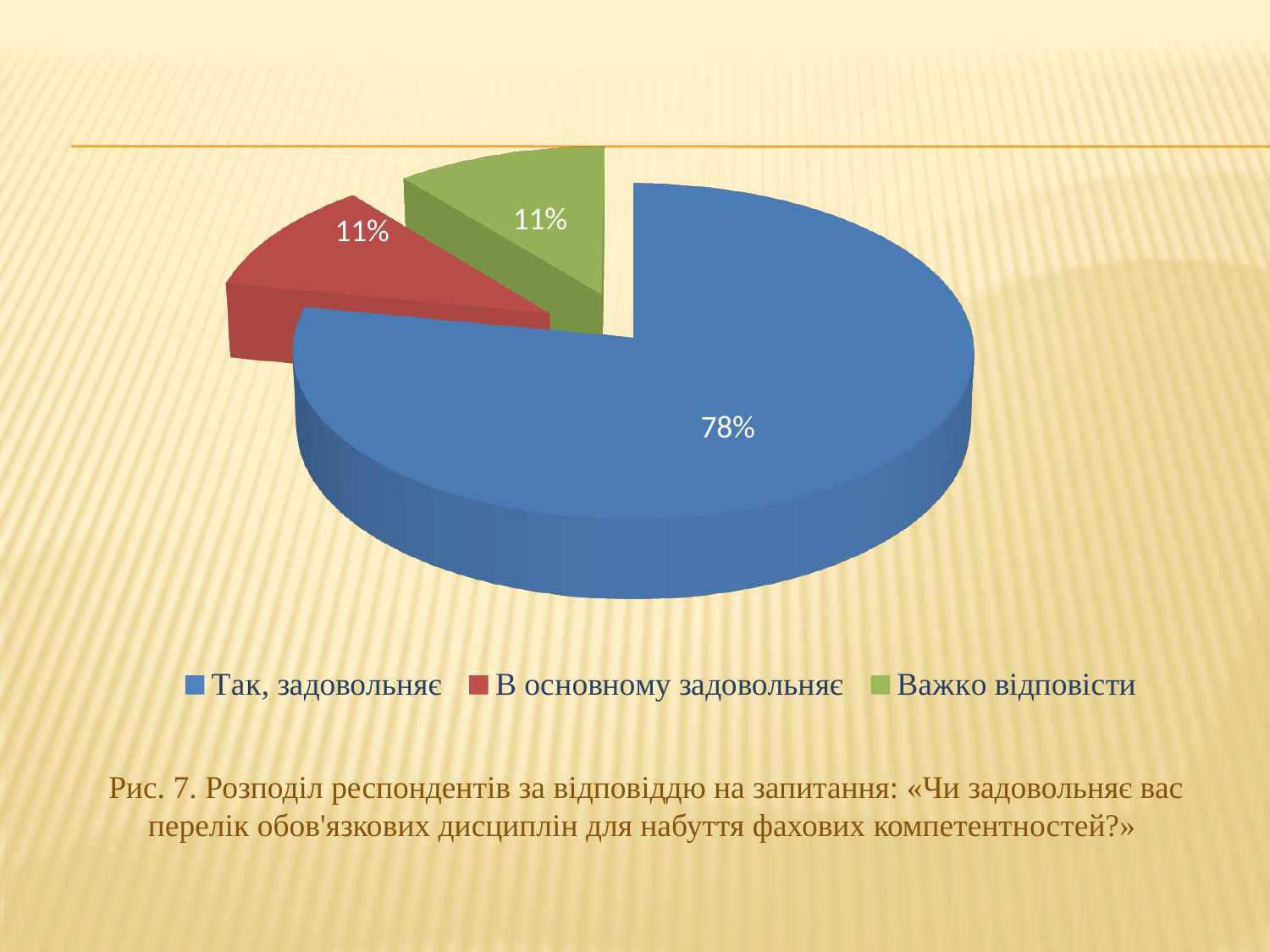
How many entries does the legend list? 3 What share of respondents answered "Так, задовольняє"? 78% What colour is the slice for "Важко відповісти"? green What is the difference in percentage points between "Так, задовольняє" and "Важко відповісти"? 67 Which answer option has the largest share of the pie? Так, задовольняє Is the share for "Так, задовольняє" greater or less than 50%? greater What is the figure number given in the caption below the chart? Рис. 7 What share of respondents answered "В основному задовольняє"? 11% What kind of chart is shown on the slide? pie chart How many slices does the pie chart have? 3 What share of respondents answered "Важко відповісти"? 11% Which is larger: the share for "Так, задовольняє" or the share for "В основному задовольняє"? Так, задовольняє